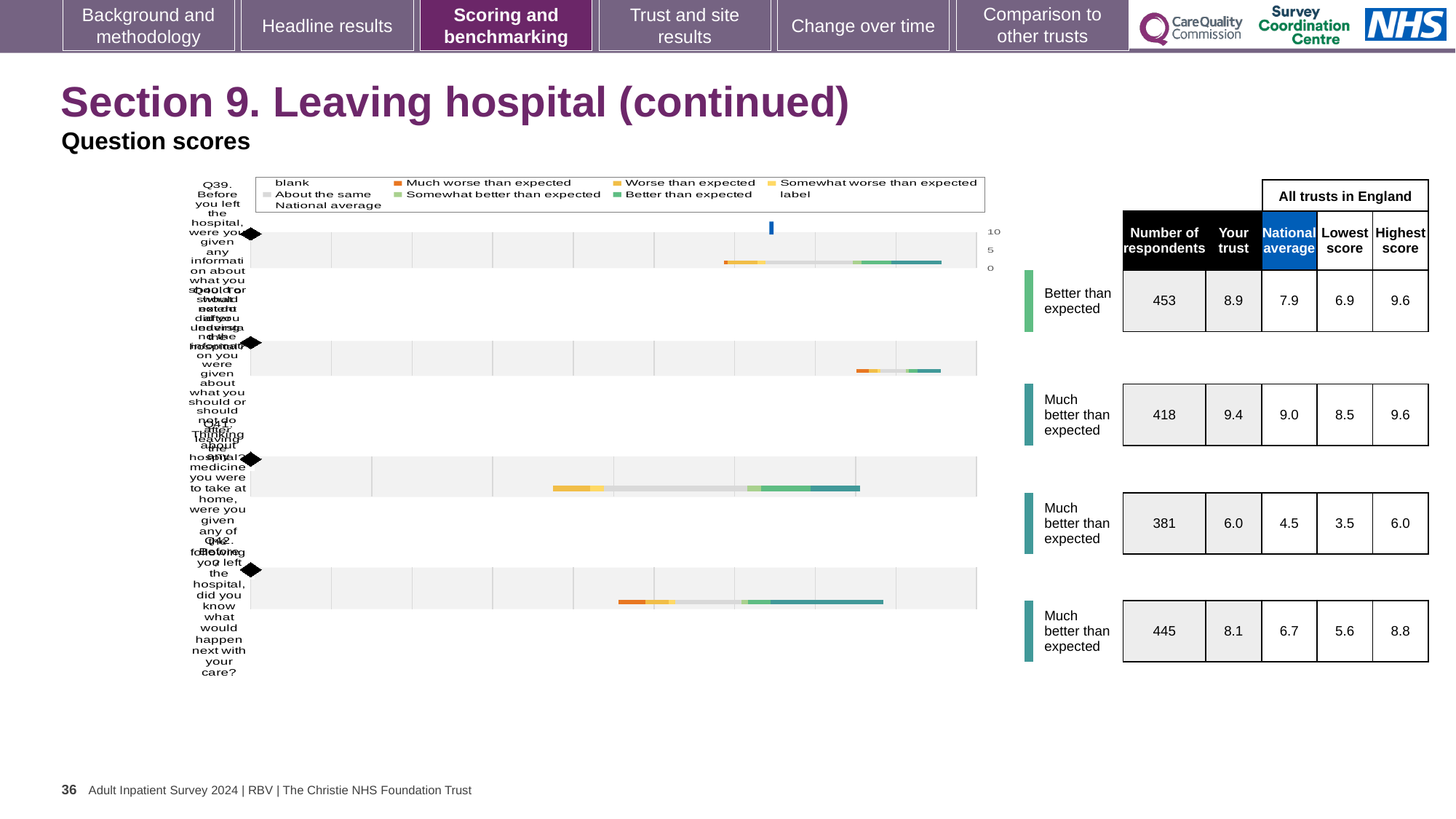
For the third row (Q41), is the 'Your trust' score or the national average larger? Your trust (6.0) What kind of chart is shown on the left of the slide? bar chart Which row in the table has the lowest 'Your trust' score? Q41 (third row), 6.0 In the table, what is the national average for the third row (Q41)? 4.5 What is the highest value shown on the chart's score axis? 10 How many question rows (Q39 to Q42) are plotted in the chart? 4 Which row in the table has the highest number of respondents? Q39 (first row), 453 In the table, what is the highest score for the fourth row (Q42)? 8.8 What is the difference between the 'Your trust' score and the national average for the fourth row (Q42)? 1.4 In the table, what is the 'Your trust' score for the second row (Q40)? 9.4 In the table, what is the number of respondents for the first row (Q39, 'Better than expected')? 453 Which legend entry is shown in orange in the chart legend? Much worse than expected